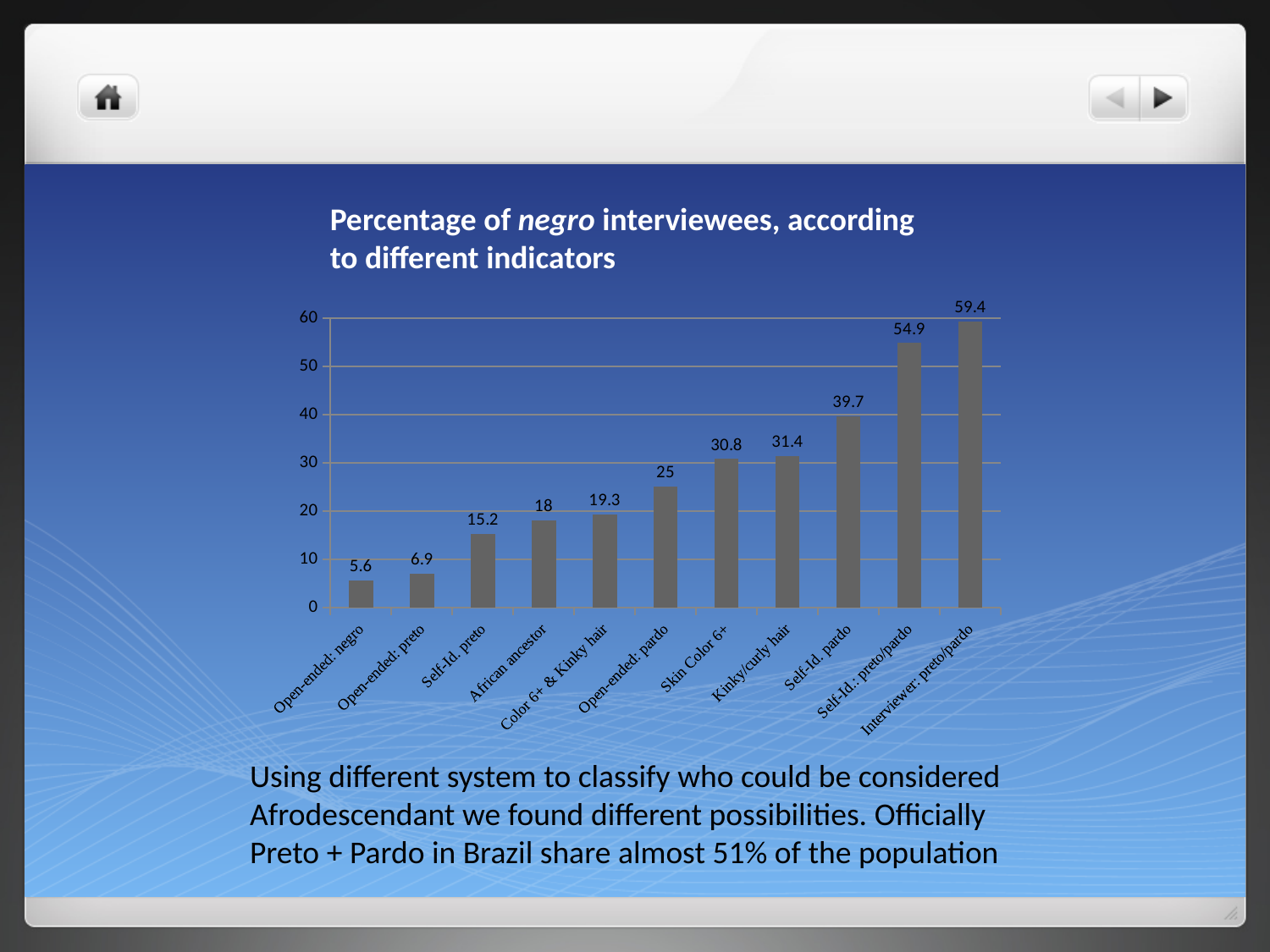
Which category has the lowest value? Open-ended: negro What kind of chart is shown on the slide? bar chart What is the title of the chart? Percentage of negro interviewees, according to different indicators Which is larger, the value for African ancestor or the value for Color 6+ & Kinky hair? Color 6+ & Kinky hair How many categories are shown on the x axis? 11 What is the value for Interviewer: preto/pardo? 59.4 Do the values rise or fall from left to right along the x axis? rise What is the value for Skin Color 6+? 30.8 What is the value for Self-Id. preto? 15.2 Is the value for Self-Id.: preto/pardo greater or less than 50? greater What is the difference between the values for Self-Id. pardo and Open-ended: pardo? 14.7 Which category has the highest value? Interviewer: preto/pardo